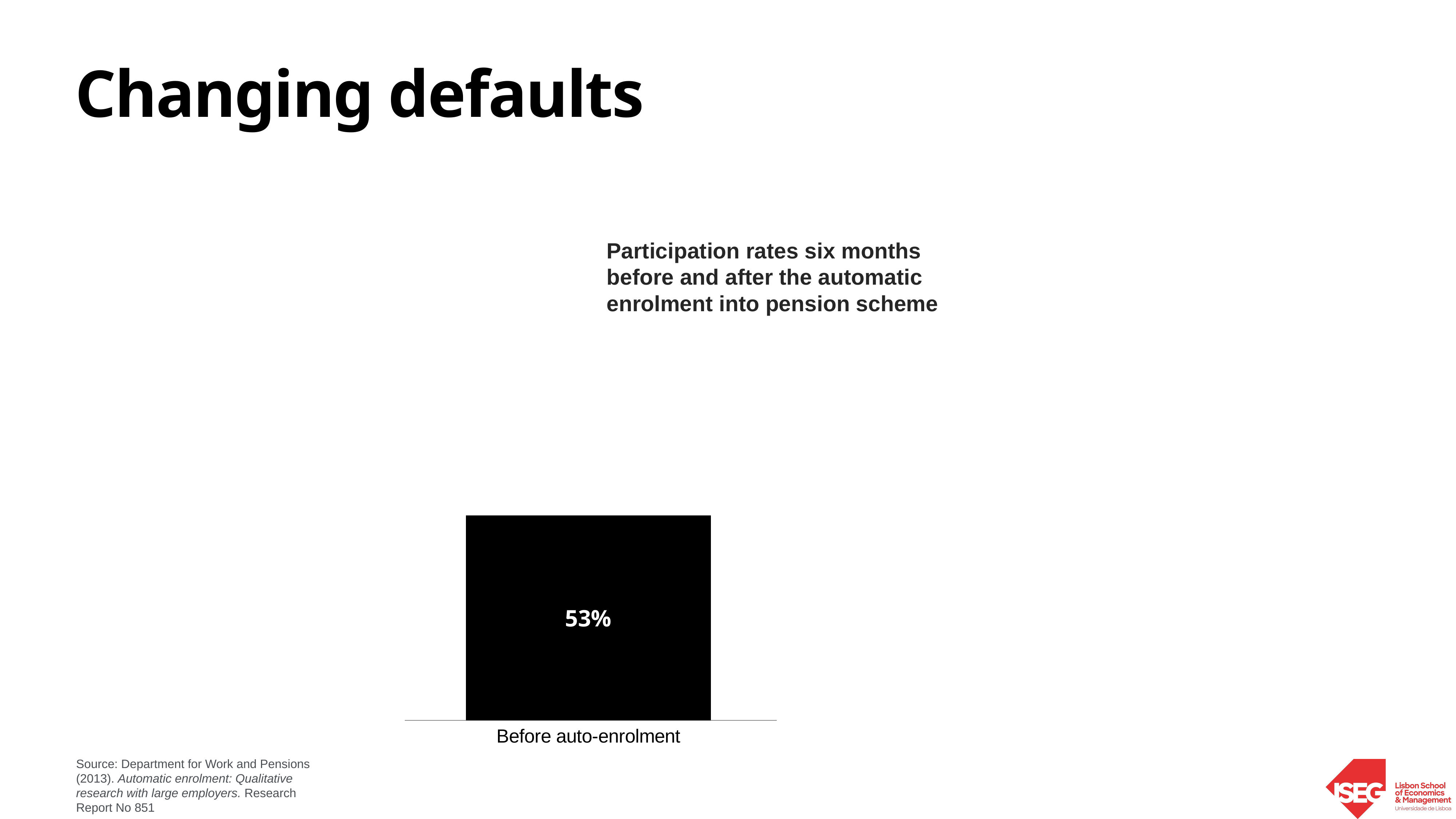
What value is printed as the data label on the Before auto-enrolment bar? 53% How many bars are plotted on the chart? 1 What kind of chart is shown on the slide? Bar chart What is the category label under the bar on the chart? Before auto-enrolment What is the participation rate shown for Before auto-enrolment? 53% What is the title of the chart? Participation rates six months before and after the automatic enrolment into pension scheme